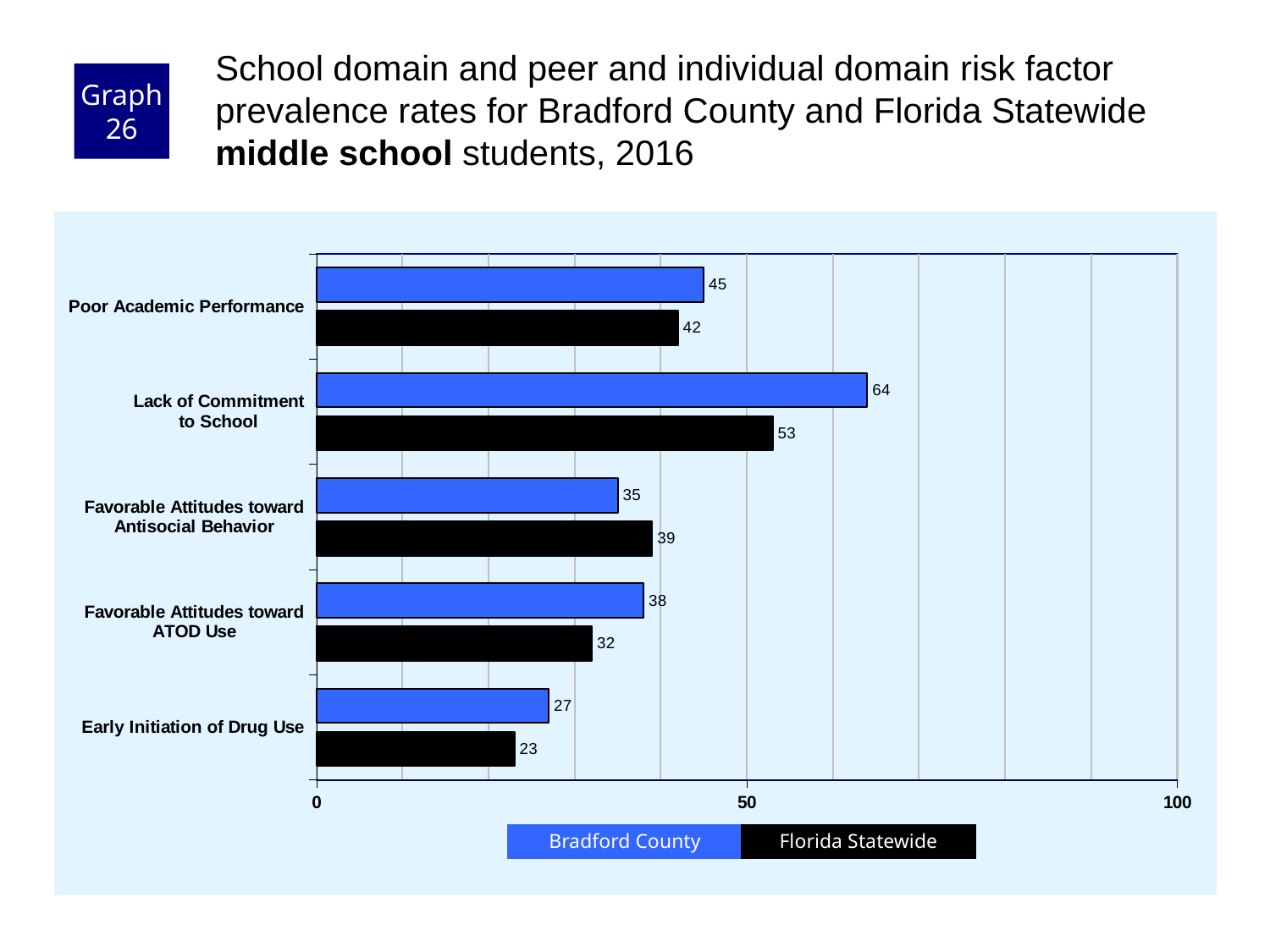
How many risk factors are shown on the chart? 5 What kind of chart is shown on the slide? bar chart Which risk factor has the highest Bradford County value? Lack of Commitment to School What is the difference between the Bradford County and Florida Statewide values for Lack of Commitment to School? 11 How many series does the legend list? 2 Which colour represents Florida Statewide in the chart? black What is the Florida Statewide value for Favorable Attitudes toward Antisocial Behavior? 39 Which risk factor has the lowest Florida Statewide value? Early Initiation of Drug Use Is the Bradford County value for Poor Academic Performance greater or less than 50? less What is the Bradford County value for Lack of Commitment to School? 64 For Favorable Attitudes toward Antisocial Behavior, which is larger: Bradford County or Florida Statewide? Florida Statewide What is the Florida Statewide value for Early Initiation of Drug Use? 23